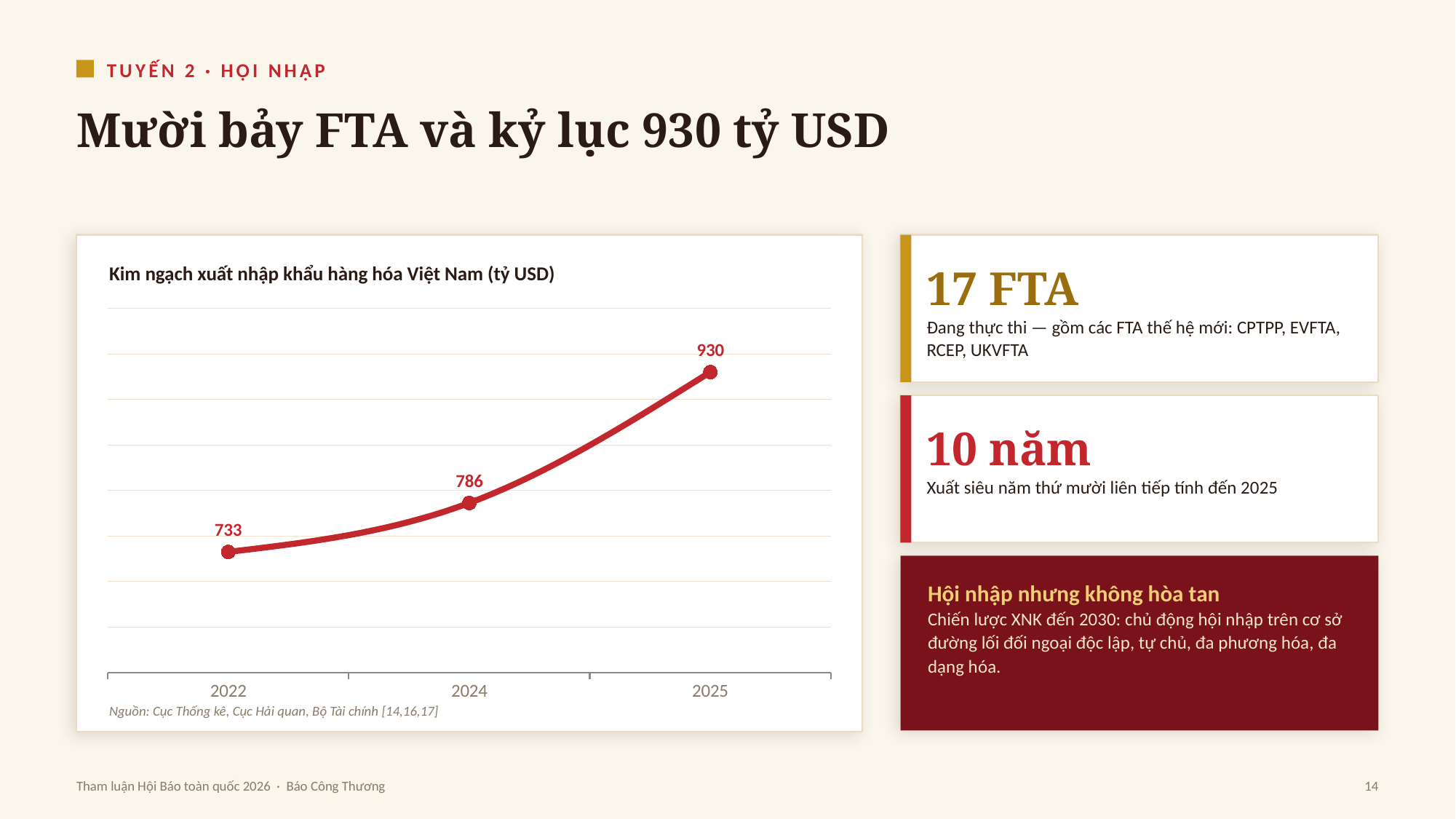
Which is larger, the value for 2024 or the value for 2022? 2024 What is the difference between the values for 2025 and 2024? 144 Which year has the highest value in the chart? 2025 How many data points are plotted in the chart? 3 Do the values rise or fall from 2022 to 2025? Rise Which year has the lowest value in the chart? 2022 What is the value for 2025 in the chart? 930 What is the value for 2024 in the chart? 786 What kind of chart is shown on the slide? Line chart What is the title of the chart? Kim ngạch xuất nhập khẩu hàng hóa Việt Nam (tỷ USD) What is the difference between the values for 2024 and 2022? 53 What is the value for 2022 in the chart? 733